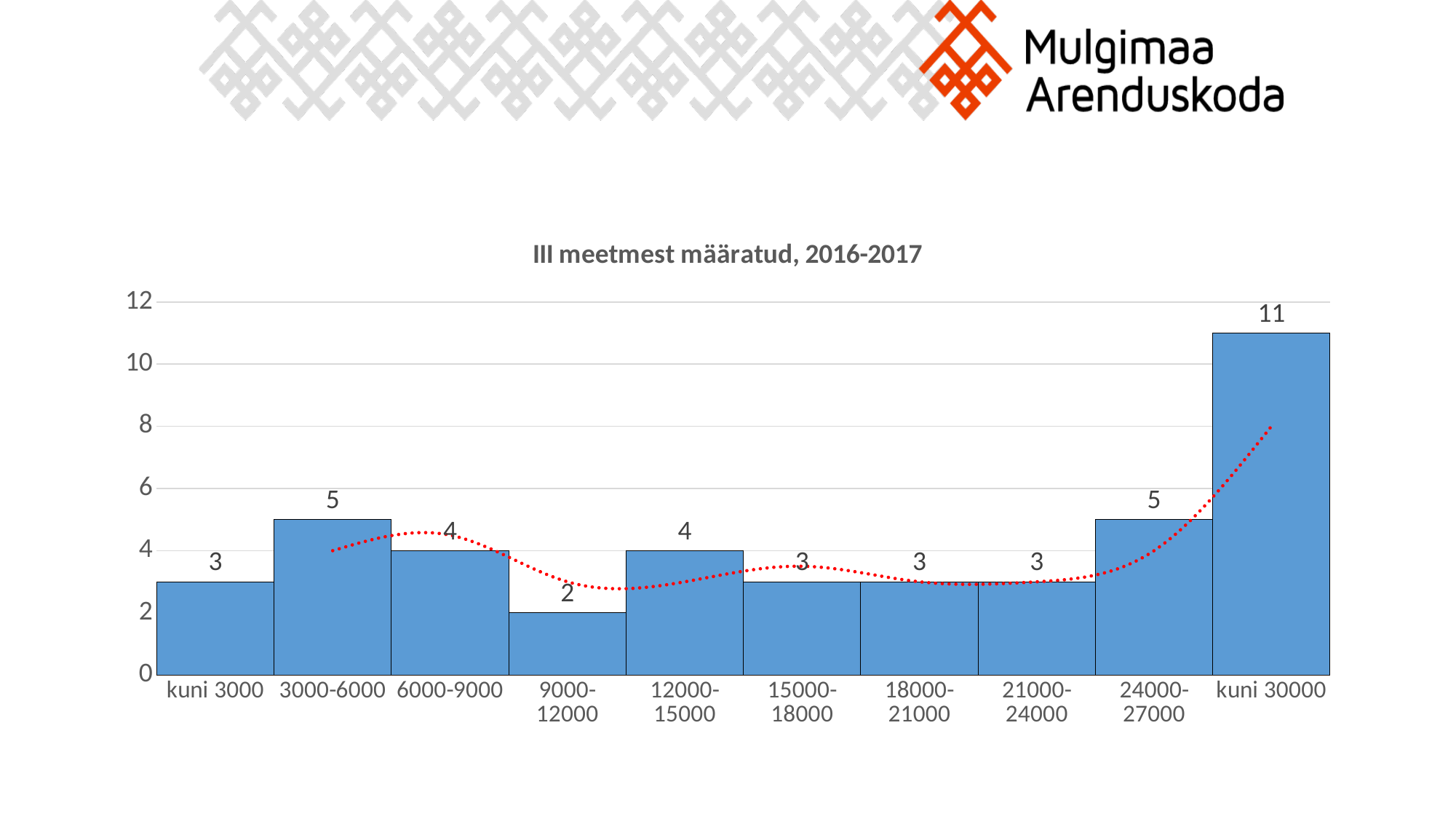
What is the value for the '9000-12000' category? 2 Which category has the lowest value? 9000-12000 What is the value for the 'kuni 30000' category? 11 Which is larger, the value for '6000-9000' or the value for '9000-12000'? 6000-9000 What is the difference between the values for 'kuni 30000' and '24000-27000'? 6 What kind of chart is this? bar chart What is the title of the chart? III meetmest määratud, 2016-2017 Which category has the highest value? kuni 30000 What is the total of the values for '15000-18000', '18000-21000' and '21000-24000'? 9 How many categories are shown on the x axis? 10 What is the value for the '3000-6000' category? 5 Is the value for 'kuni 30000' greater or less than 10? greater